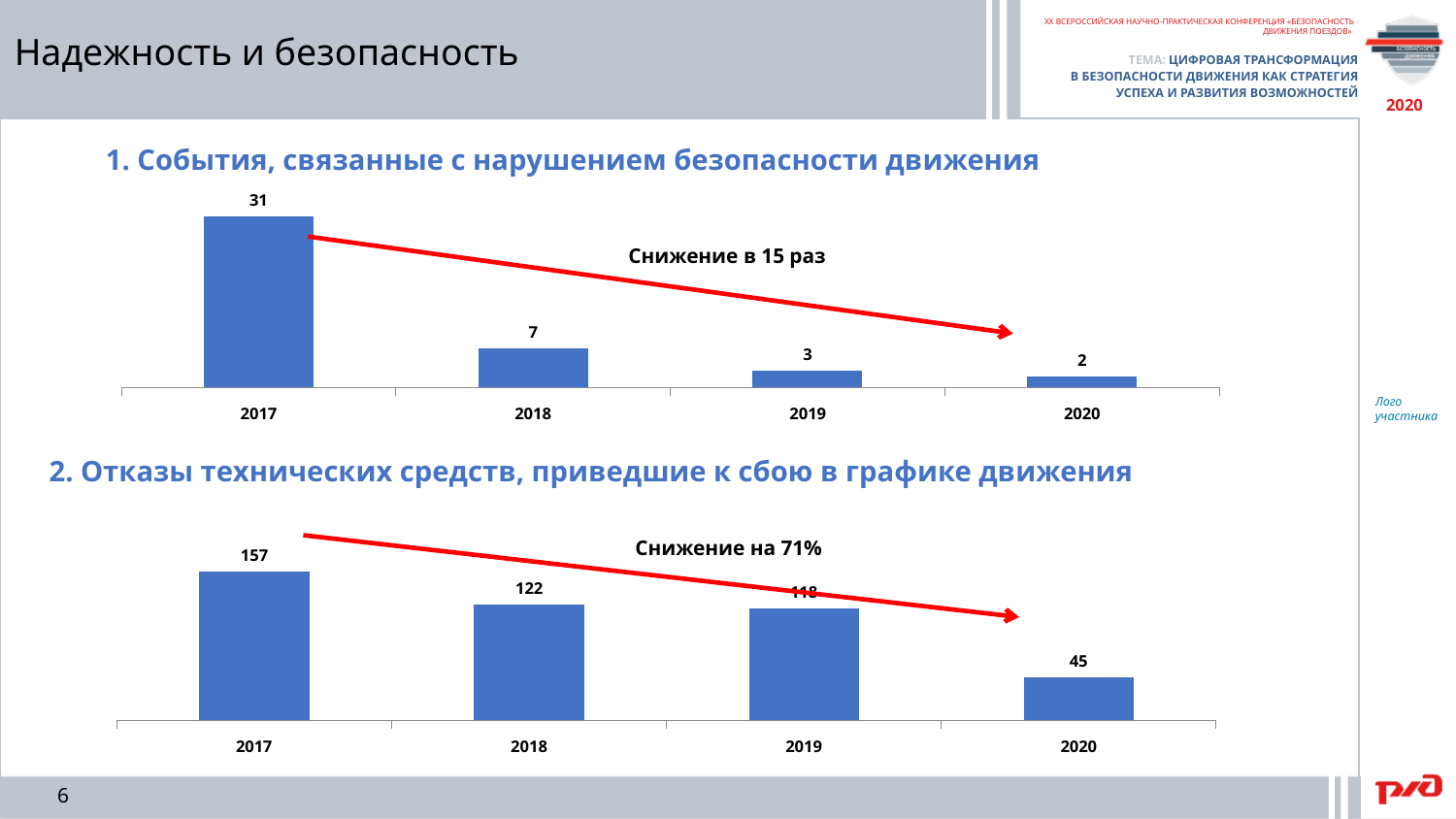
In the chart "Отказы технических средств, приведшие к сбою в графике движения", what is the value for 2020? 45 In the chart "Отказы технических средств, приведшие к сбою в графике движения", which is larger, the value for 2018 or the value for 2020? 2018 What type of chart is the lower chart on the slide? bar chart In the chart "События, связанные с нарушением безопасности движения", how many years are shown? 4 In the chart "Отказы технических средств, приведшие к сбою в графике движения", which year has the highest value? 2017 In the chart "Отказы технических средств, приведшие к сбою в графике движения", what is the value for 2017? 157 In the chart "События, связанные с нарушением безопасности движения", what is the value for 2019? 3 In the chart "События, связанные с нарушением безопасности движения", do the values rise or fall from 2017 to 2020? fall In the chart "Отказы технических средств, приведшие к сбою в графике движения", what is the difference between the values for 2018 and 2020? 77 In the chart "События, связанные с нарушением безопасности движения", what is the value for 2017? 31 In the chart "События, связанные с нарушением безопасности движения", what is the difference between the values for 2017 and 2018? 24 In the chart "События, связанные с нарушением безопасности движения", which year has the lowest value? 2020